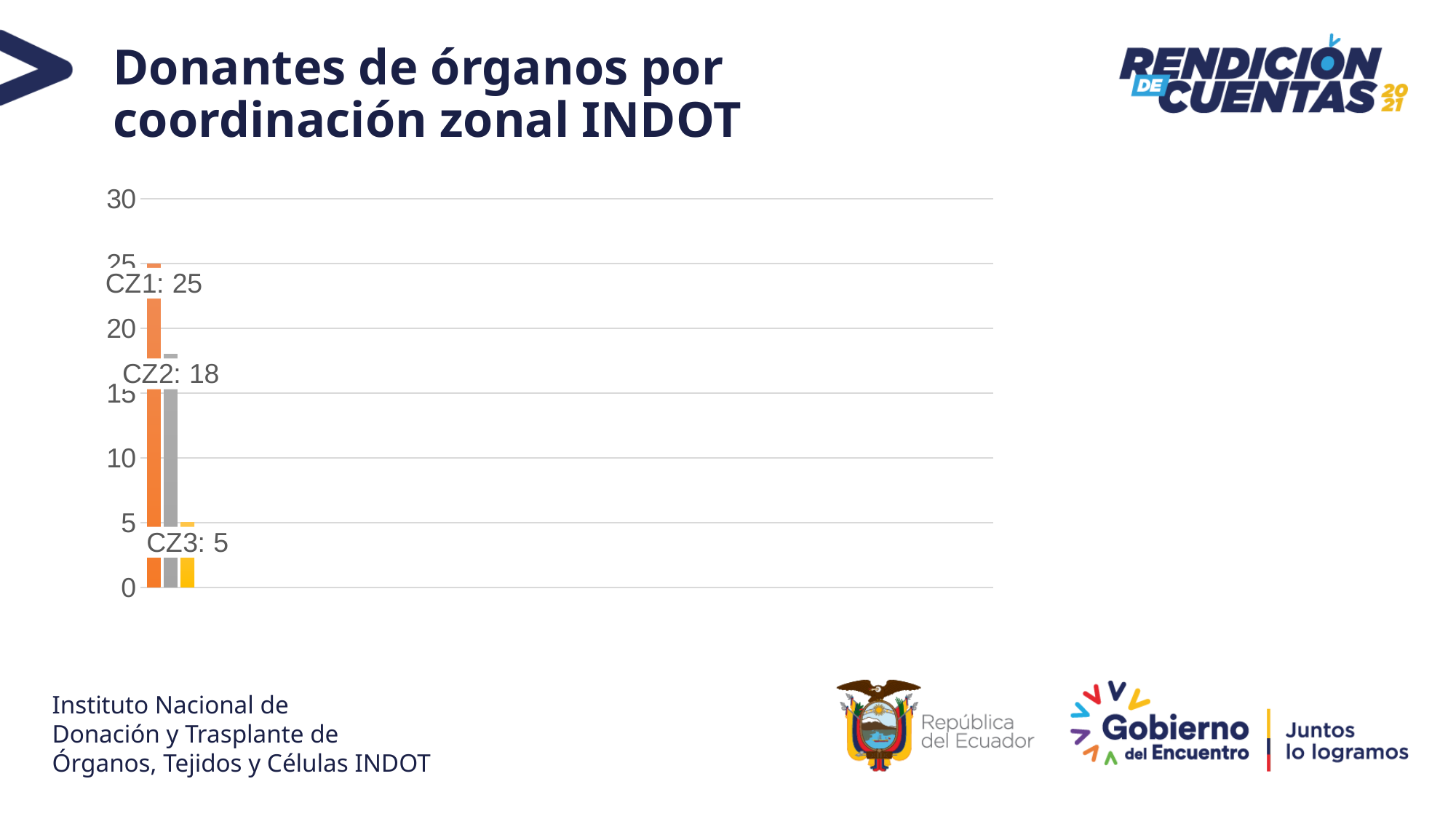
Which is larger, the value for CZ2 or the value for CZ3? CZ2 Which coordinación zonal has the highest number of donors? CZ1 What is the value for CZ1? 25 What is the title of the slide's chart? Donantes de órganos por coordinación zonal INDOT What is the difference between the values for CZ2 and CZ3? 13 What is the value for CZ2? 18 How many categories are shown in the chart? 3 What is the value for CZ3? 5 Which coordinación zonal has the lowest number of donors? CZ3 What kind of chart is shown on the slide? bar chart Is the value for CZ1 greater or less than 20? greater What is the difference between the values for CZ1 and CZ2? 7